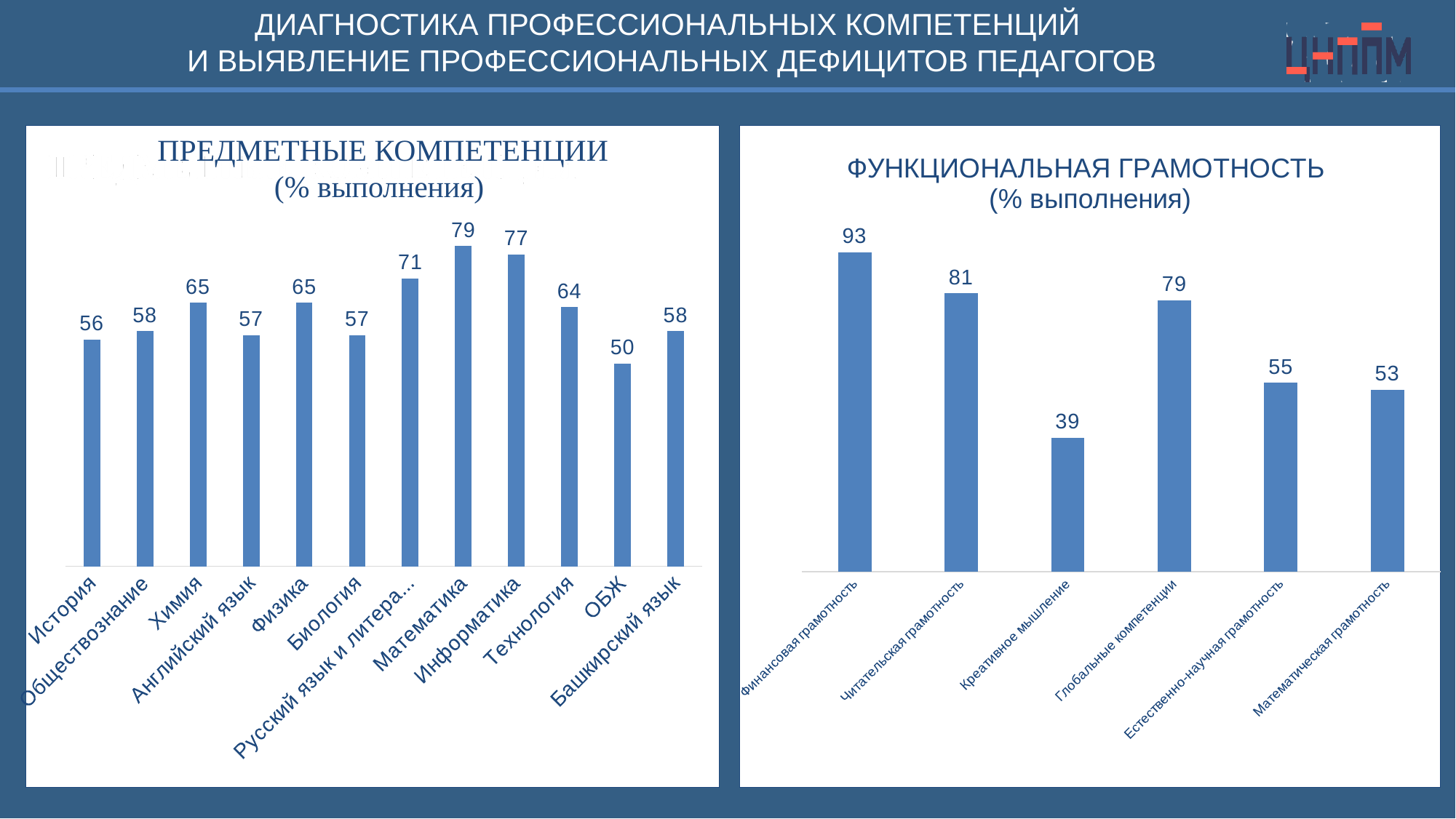
In the chart titled "ФУНКЦИОНАЛЬНАЯ ГРАМОТНОСТЬ", what is the difference between the values for Финансовая грамотность and Математическая грамотность? 40 In the chart titled "ПРЕДМЕТНЫЕ КОМПЕТЕНЦИИ", which category has the highest value? Математика In the chart titled "ФУНКЦИОНАЛЬНАЯ ГРАМОТНОСТЬ", which category has the lowest value? Креативное мышление In the chart titled "ПРЕДМЕТНЫЕ КОМПЕТЕНЦИИ", which category has the lowest value? ОБЖ What kind of chart is the chart titled "ФУНКЦИОНАЛЬНАЯ ГРАМОТНОСТЬ"? Bar chart In the chart titled "ПРЕДМЕТНЫЕ КОМПЕТЕНЦИИ", what is the difference between the values for Информатика and Технология? 13 In the chart titled "ПРЕДМЕТНЫЕ КОМПЕТЕНЦИИ", how many categories are shown? 12 In the chart titled "ПРЕДМЕТНЫЕ КОМПЕТЕНЦИИ", what is the value for Математика? 79 In the chart titled "ФУНКЦИОНАЛЬНАЯ ГРАМОТНОСТЬ", which category has the highest value? Финансовая грамотность In the chart titled "ПРЕДМЕТНЫЕ КОМПЕТЕНЦИИ", what is the value for ОБЖ? 50 In the chart titled "ФУНКЦИОНАЛЬНАЯ ГРАМОТНОСТЬ", which is larger: the value for Читательская грамотность or Глобальные компетенции? Читательская грамотность In the chart titled "ФУНКЦИОНАЛЬНАЯ ГРАМОТНОСТЬ", what is the value for Креативное мышление? 39